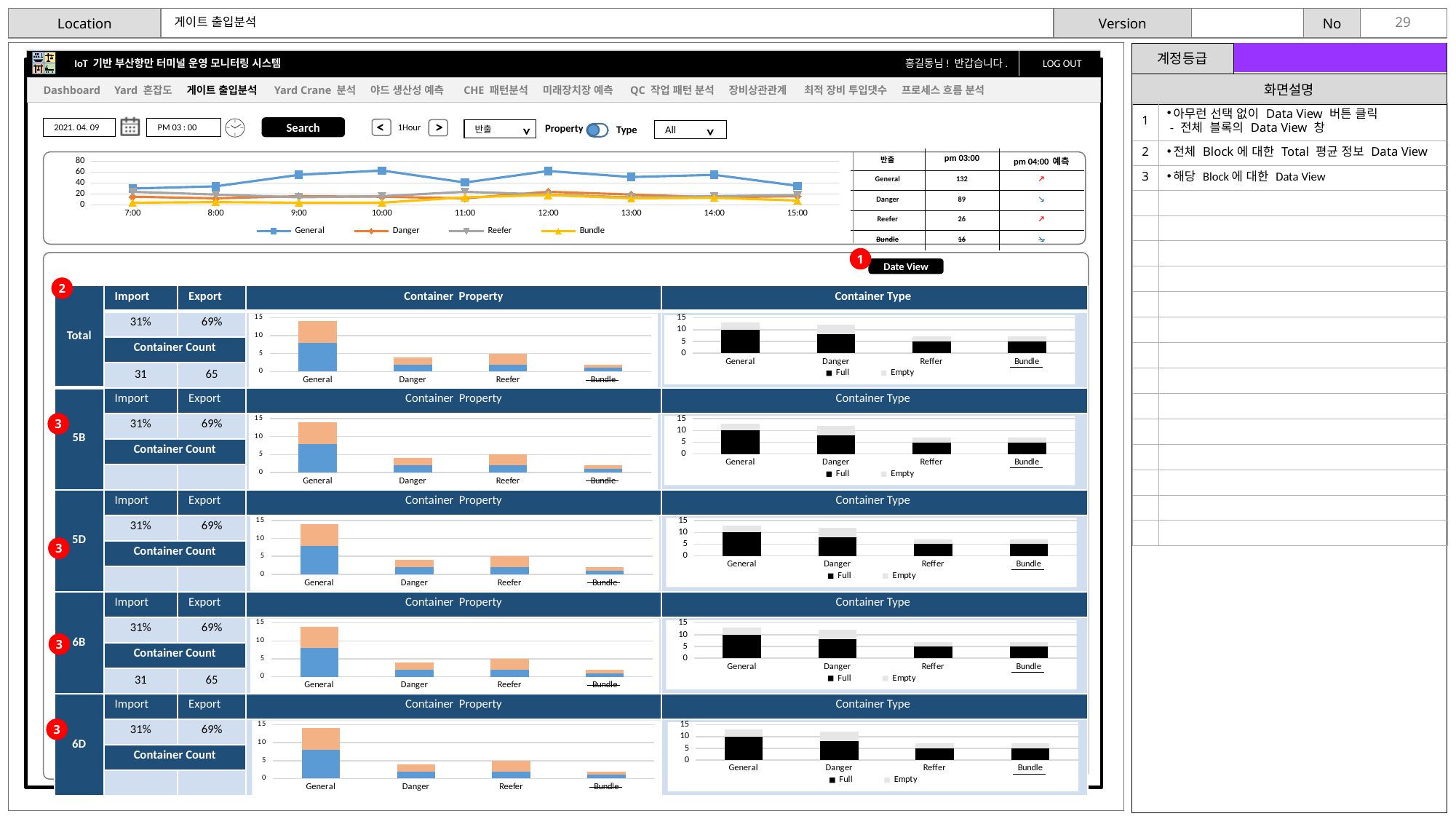
In the Total row's Container Type chart, how many series does the legend list? 2 In the top line chart, which series has the highest values across the time points? General In the top line chart, how many time points are shown on the x axis? 9 In the top line chart, does the General series rise or fall from 7:00 to 10:00? rise In the Total row's Container Property chart, is the total for General greater or less than 10? greater In the top line chart, is the value for General at 10:00 greater or less than 40? greater What kind of chart is the chart at the top of the slide showing values from 7:00 to 15:00? line chart In the top line chart, which is larger at 12:00, General or Bundle? General In the top line chart, how many series does the legend list? 4 In the Total row's Container Property chart, which category has the tallest bar? General In the top line chart, is the value for General at 7:00 greater or less than 40? less In the Total row's Container Property chart, which category has the shortest bar? Bundle